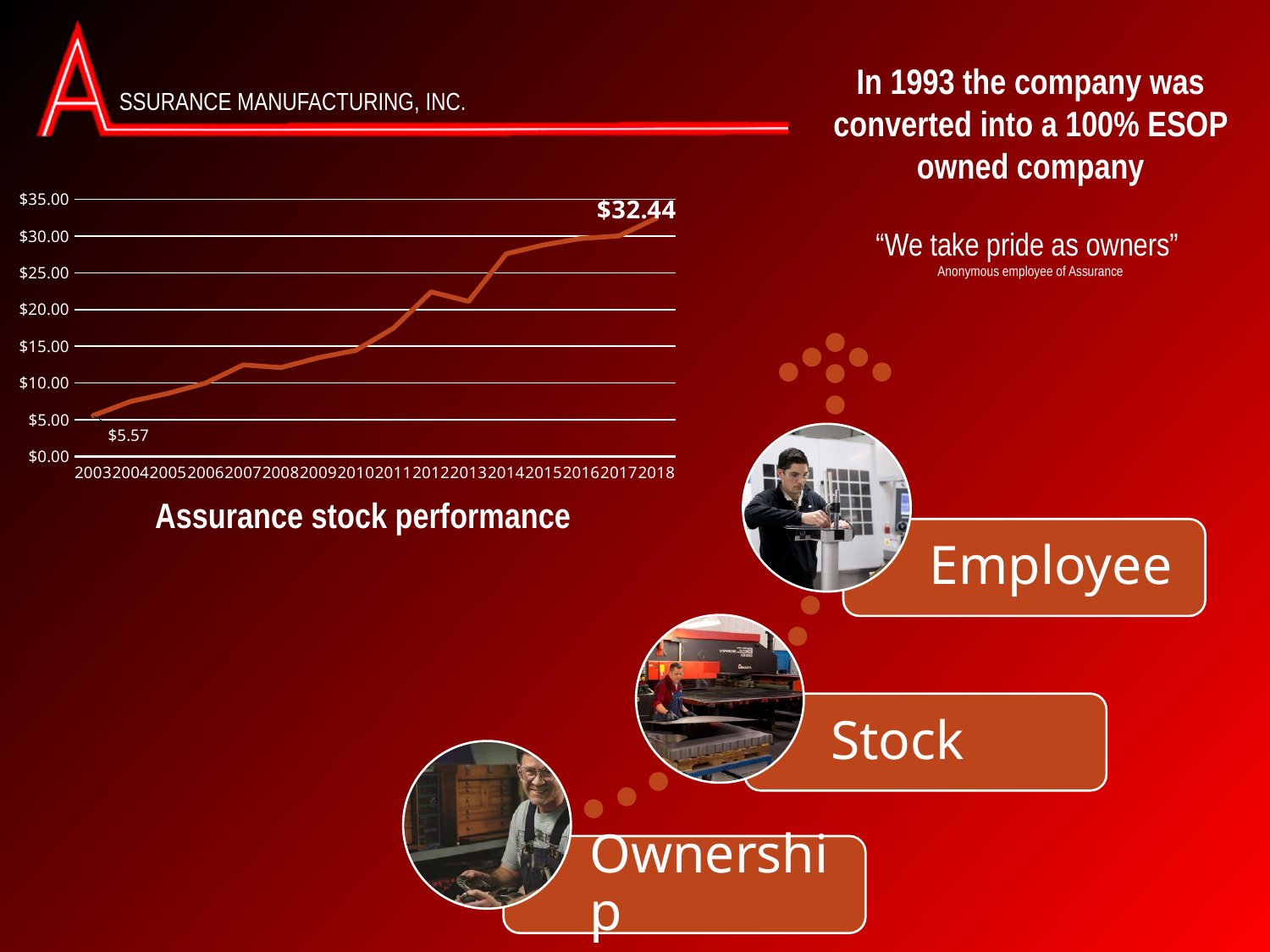
What is the title of the chart? Assurance stock performance What is the stock value shown for 2003? $5.57 What is the difference between the 2018 value and the 2003 value? $26.87 What is the stock value shown for 2018? $32.44 How many years are plotted on the x axis? 16 Which year has the highest stock value? 2018 Is the value for 2005 greater or less than $10.00? less Is the value for 2014 greater or less than $25.00? greater Is the value for 2012 greater or less than $20.00? greater Which year has the lowest stock value? 2003 What type of chart is shown on the slide? line chart Do the stock values generally rise or fall from 2003 to 2018? rise